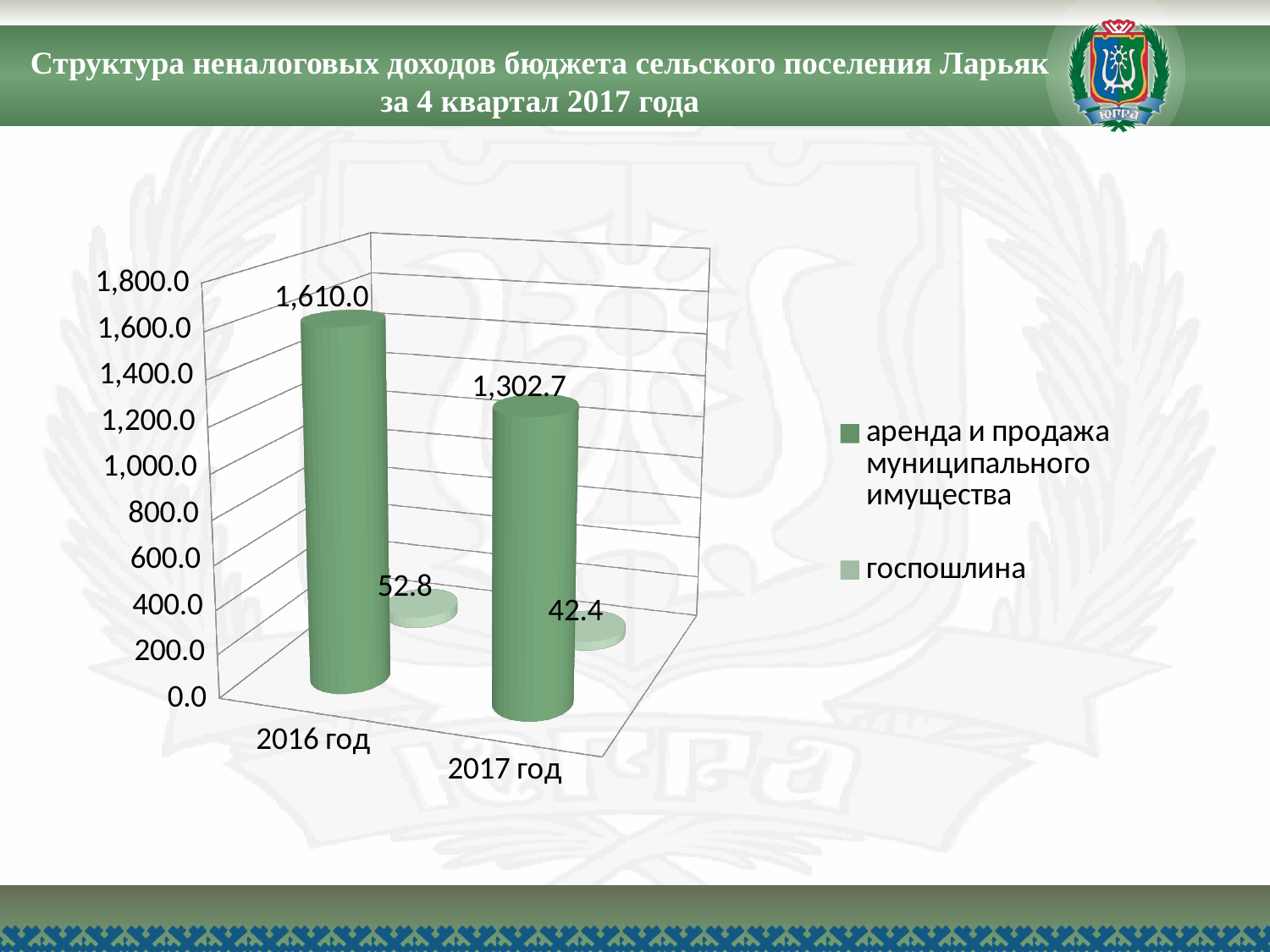
How many series does the legend list? 2 What is the value for 'госпошлина' in 2016 год? 52.8 What is the difference between the 'аренда и продажа муниципального имущества' values for 2016 год and 2017 год? 307.3 Do the values for 'аренда и продажа муниципального имущества' rise or fall from 2016 год to 2017 год? fall What is the difference between the 'госпошлина' values for 2016 год and 2017 год? 10.4 What kind of chart is shown on the slide? bar chart What is the value for 'госпошлина' in 2017 год? 42.4 Which is larger: 'госпошлина' in 2016 год or 'госпошлина' in 2017 год? 2016 год Which year has the lower value for 'госпошлина'? 2017 год What is the value for 'аренда и продажа муниципального имущества' in 2016 год? 1,610.0 Which year has the higher value for 'аренда и продажа муниципального имущества'? 2016 год What is the value for 'аренда и продажа муниципального имущества' in 2017 год? 1,302.7